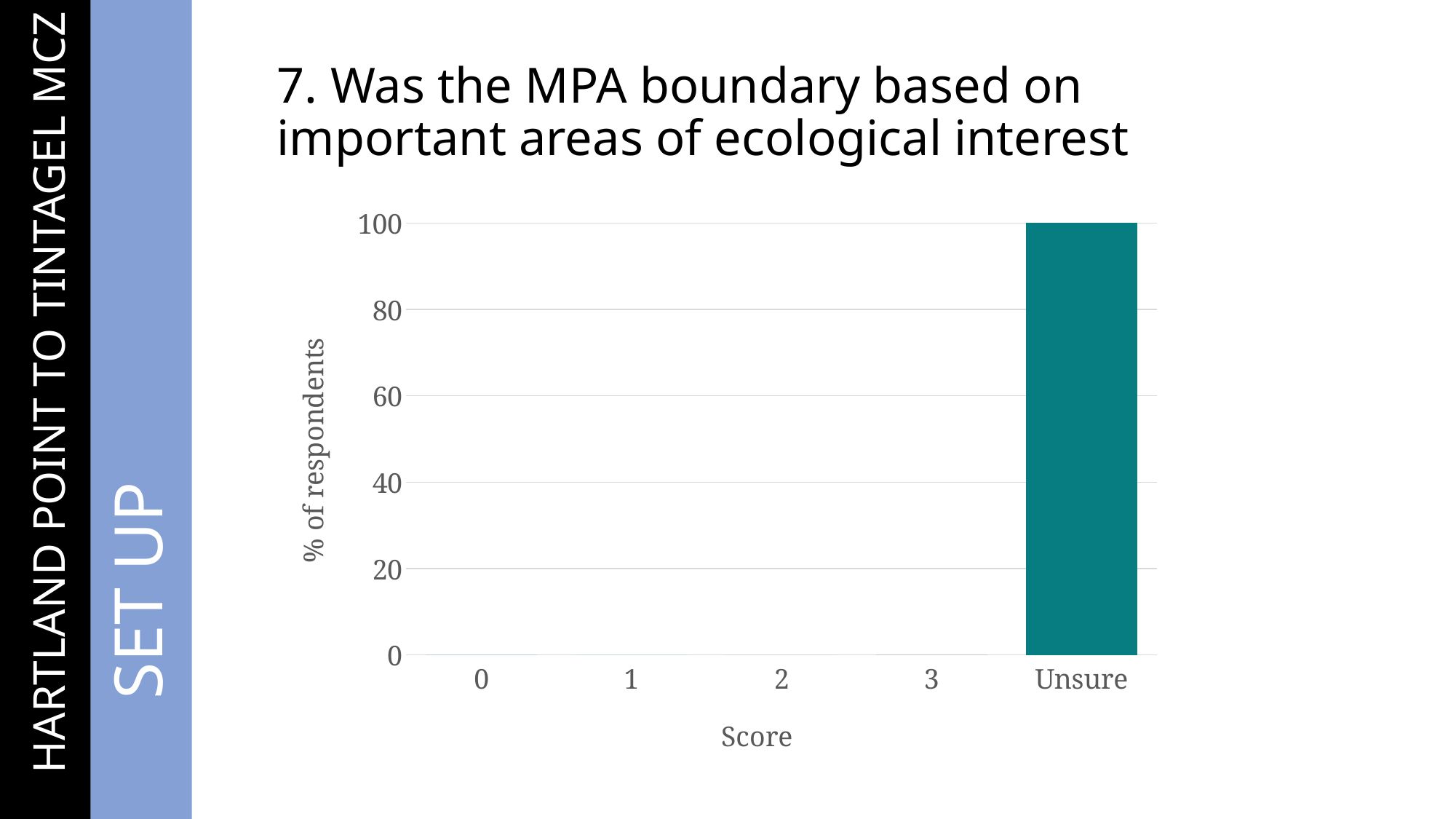
What is the title of the vertical axis? % of respondents What kind of chart is shown on the slide? bar chart Is the value for score 1 greater or less than 20? less What is the title of the horizontal axis? Score Is the value for Unsure greater or less than 80? greater What is the value for the Unsure category? 100 What is the value for score 2? 0 How many categories are shown on the x axis of the chart? 5 Which category has the highest value in the chart? Unsure What is the difference between the value for Unsure and the value for score 0? 100 Which is larger, the value for Unsure or the value for score 3? Unsure How many categories have a visible bar in the chart? 1